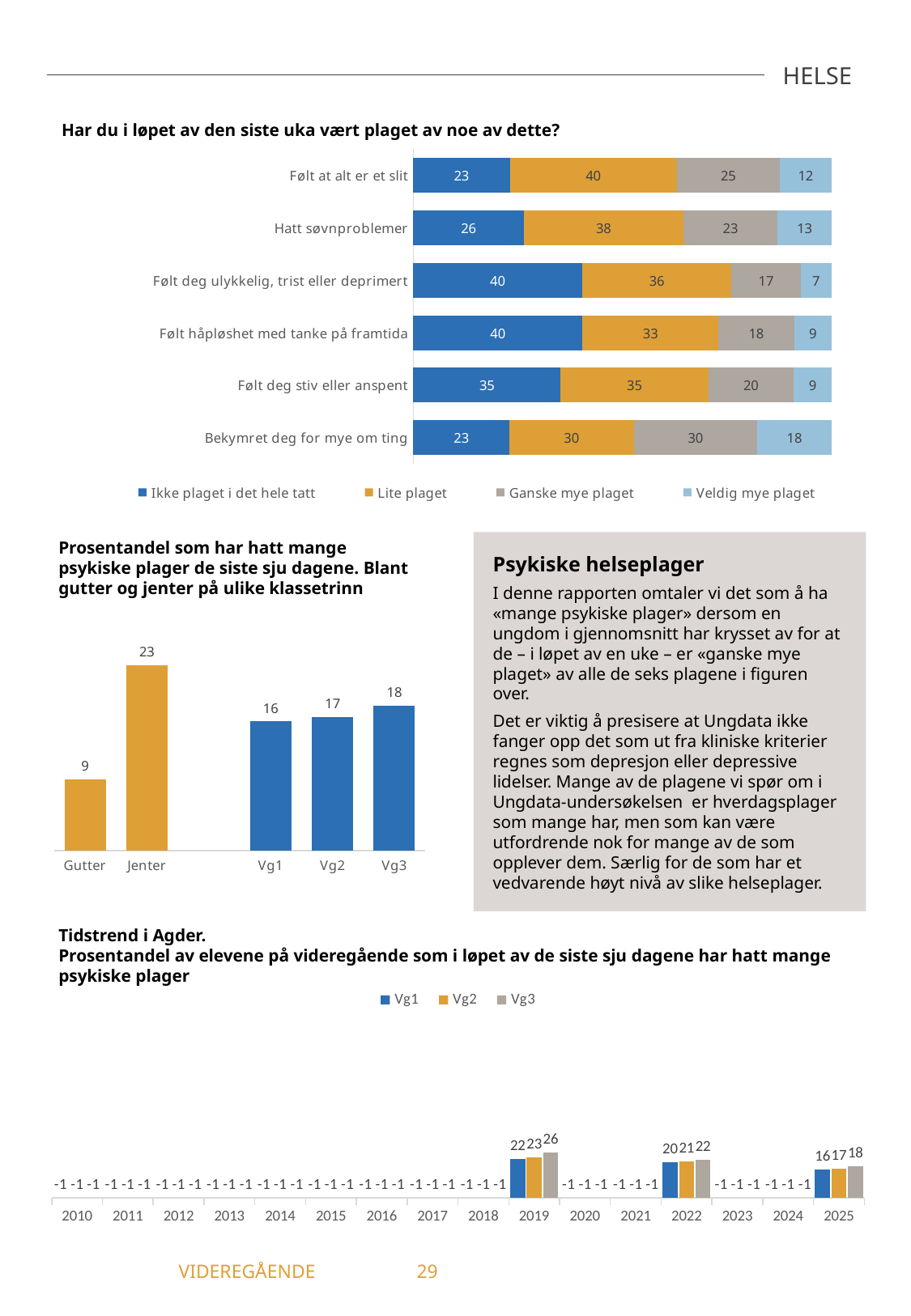
In the chart 'Har du i løpet av den siste uka vært plaget av noe av dette?', which category has the highest 'Ikke plaget i det hele tatt' value? Følt deg ulykkelig, trist eller deprimert and Følt håpløshet med tanke på framtida (both 40) In the chart 'Prosentandel som har hatt mange psykiske plager de siste sju dagene', what is the difference between Jenter and Gutter? 14 In the chart 'Har du i løpet av den siste uka vært plaget av noe av dette?', what is the value for 'Veldig mye plaget' in the 'Bekymret deg for mye om ting' bar? 18 In the chart 'Tidstrend i Agder', what is the value for Vg3 in 2019? 26 In the chart 'Tidstrend i Agder', which is larger, the Vg1 value in 2022 or the Vg1 value in 2025? 2022 In the chart 'Prosentandel som har hatt mange psykiske plager de siste sju dagene', what is the value for Jenter? 23 In the chart 'Prosentandel som har hatt mange psykiske plager de siste sju dagene', do the values rise or fall from Vg1 to Vg3? Rise In the chart 'Har du i løpet av den siste uka vært plaget av noe av dette?', how many series does the legend list? 4 In the chart 'Har du i løpet av den siste uka vært plaget av noe av dette?', what is the total of the 'Hatt søvnproblemer' bar? 100 In the chart 'Har du i løpet av den siste uka vært plaget av noe av dette?', what kind of chart is it? Stacked bar chart In the chart 'Har du i løpet av den siste uka vært plaget av noe av dette?', what is the value for 'Lite plaget' in the 'Følt at alt er et slit' bar? 40 In the chart 'Prosentandel som har hatt mange psykiske plager de siste sju dagene', which category has the lowest value? Gutter